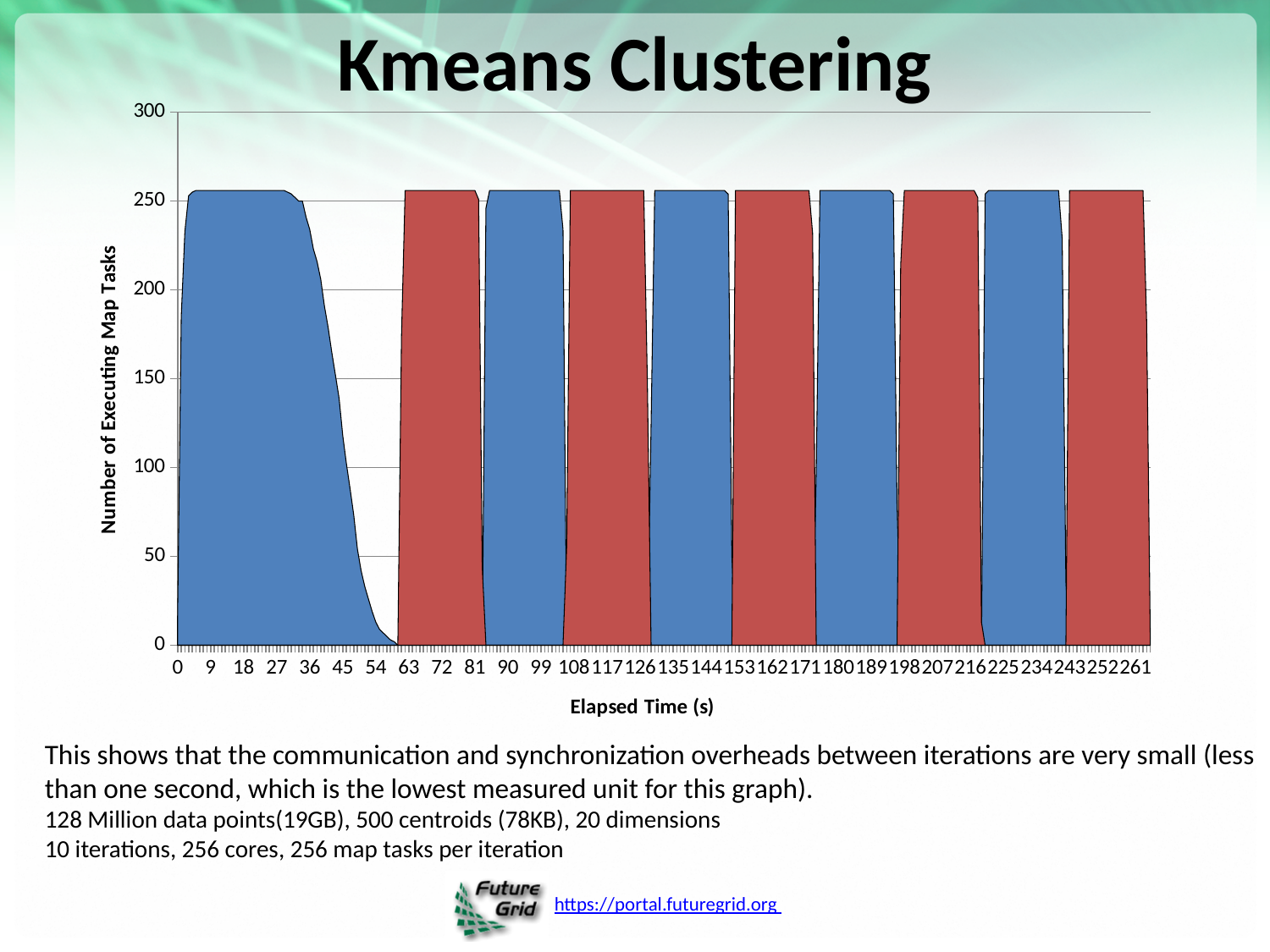
Is the number of executing map tasks at 54 s greater or less than 50? less Is the plateau value of the shaded regions greater or less than 200? greater What is the last tick label on the horizontal axis? 261 Between 36 s and 54 s, does the number of executing map tasks rise or fall? fall What kind of chart is shown on the slide? Area chart How many separate shaded regions (iterations) are plotted in the chart? 10 What is the highest value shown on the vertical axis? 300 What is the title of the chart? Kmeans Clustering Is the number of executing map tasks at 18 s greater or less than 200? greater